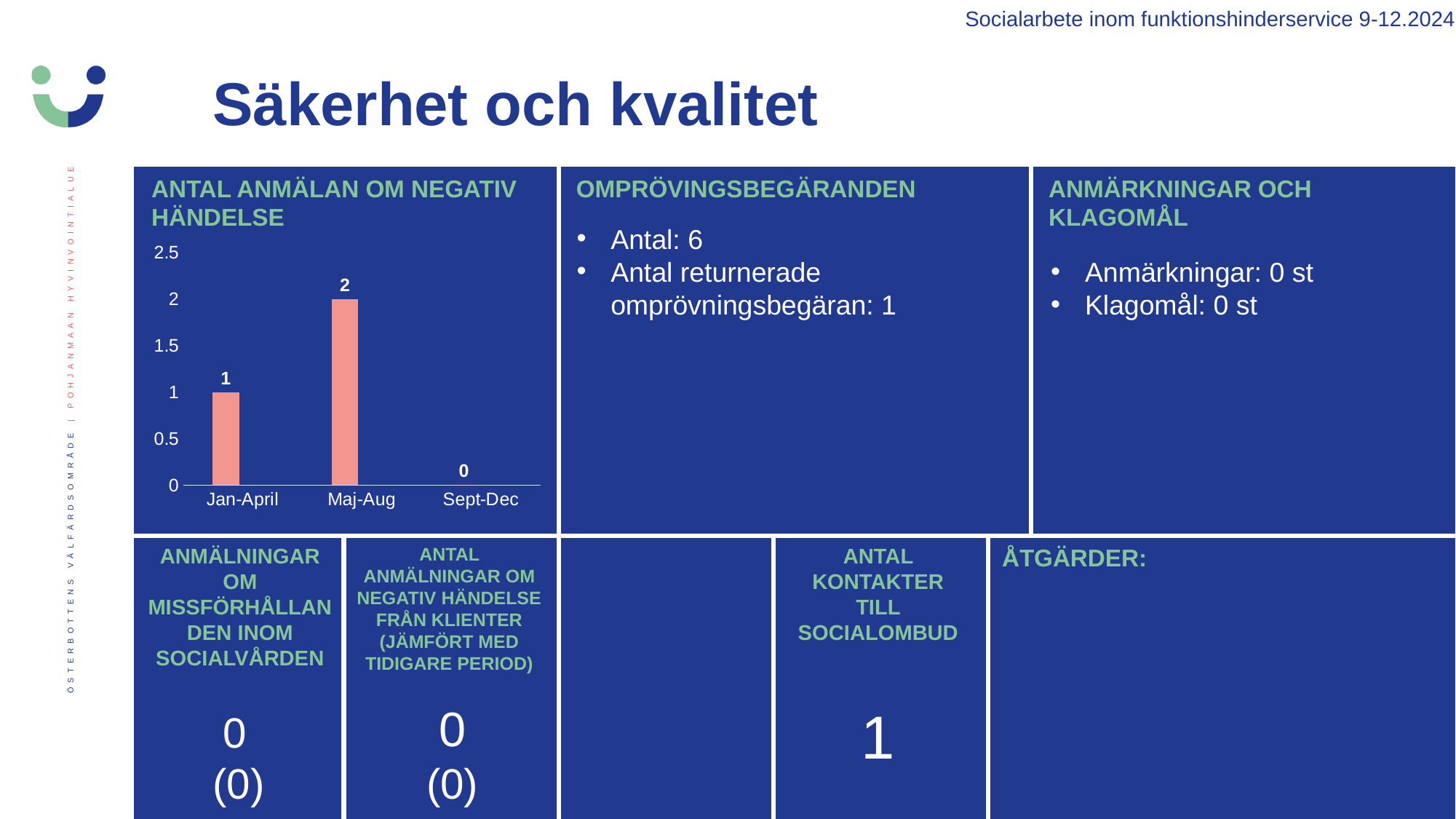
What colour are the bars in the chart 'Antal anmälan om negativ händelse'? salmon pink What kind of chart is 'Antal anmälan om negativ händelse'? bar chart What is the value for Sept-Dec in the chart 'Antal anmälan om negativ händelse'? 0 How many periods are shown on the x axis of the chart 'Antal anmälan om negativ händelse'? 3 Is the value for Maj-Aug in the chart 'Antal anmälan om negativ händelse' greater or less than 1.5? greater What is the highest tick value on the y axis of the chart 'Antal anmälan om negativ händelse'? 2.5 What is the value for Maj-Aug in the chart 'Antal anmälan om negativ händelse'? 2 Which period has the lowest value in the chart 'Antal anmälan om negativ händelse'? Sept-Dec In the chart 'Antal anmälan om negativ händelse', which is larger: Jan-April or Maj-Aug? Maj-Aug What is the difference between the Maj-Aug and Jan-April values in the chart 'Antal anmälan om negativ händelse'? 1 What is the value for Jan-April in the chart 'Antal anmälan om negativ händelse'? 1 Which period has the highest value in the chart 'Antal anmälan om negativ händelse'? Maj-Aug